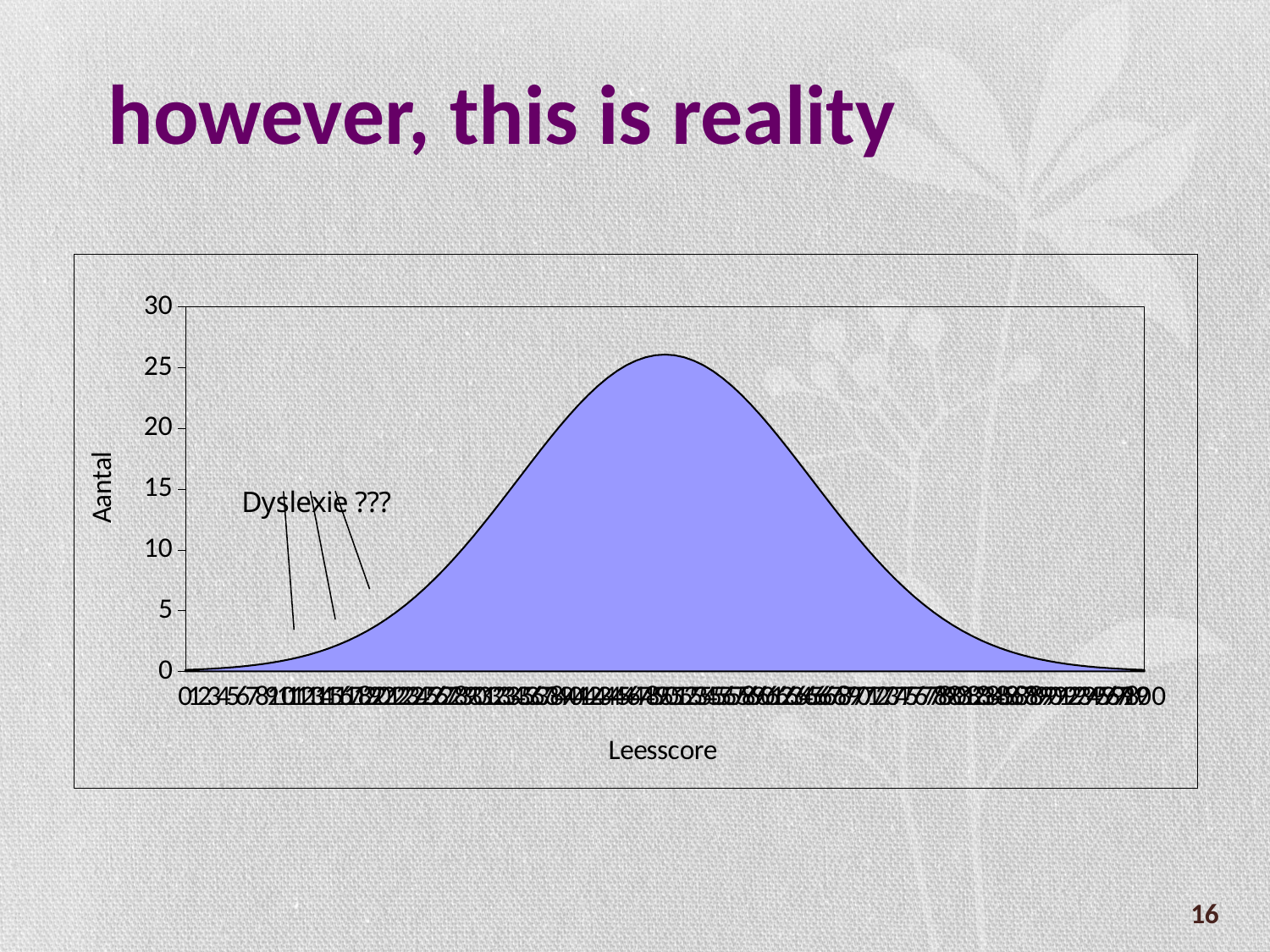
What text annotation is written inside the chart near the left tail of the curve? Dyslexie ??? Do the values rise or fall moving from the left edge of the chart toward the centre? rise What is the highest tick value shown on the y axis? 30 Is the peak value of the curve greater or less than 30? less What is the title of the y axis? Aantal Is the peak value of the curve greater or less than 20? greater What kind of chart is shown on the slide? area chart Is the value at the far right end of the x axis greater or less than 5? less Do the values rise or fall moving from the centre of the chart toward the right edge? fall